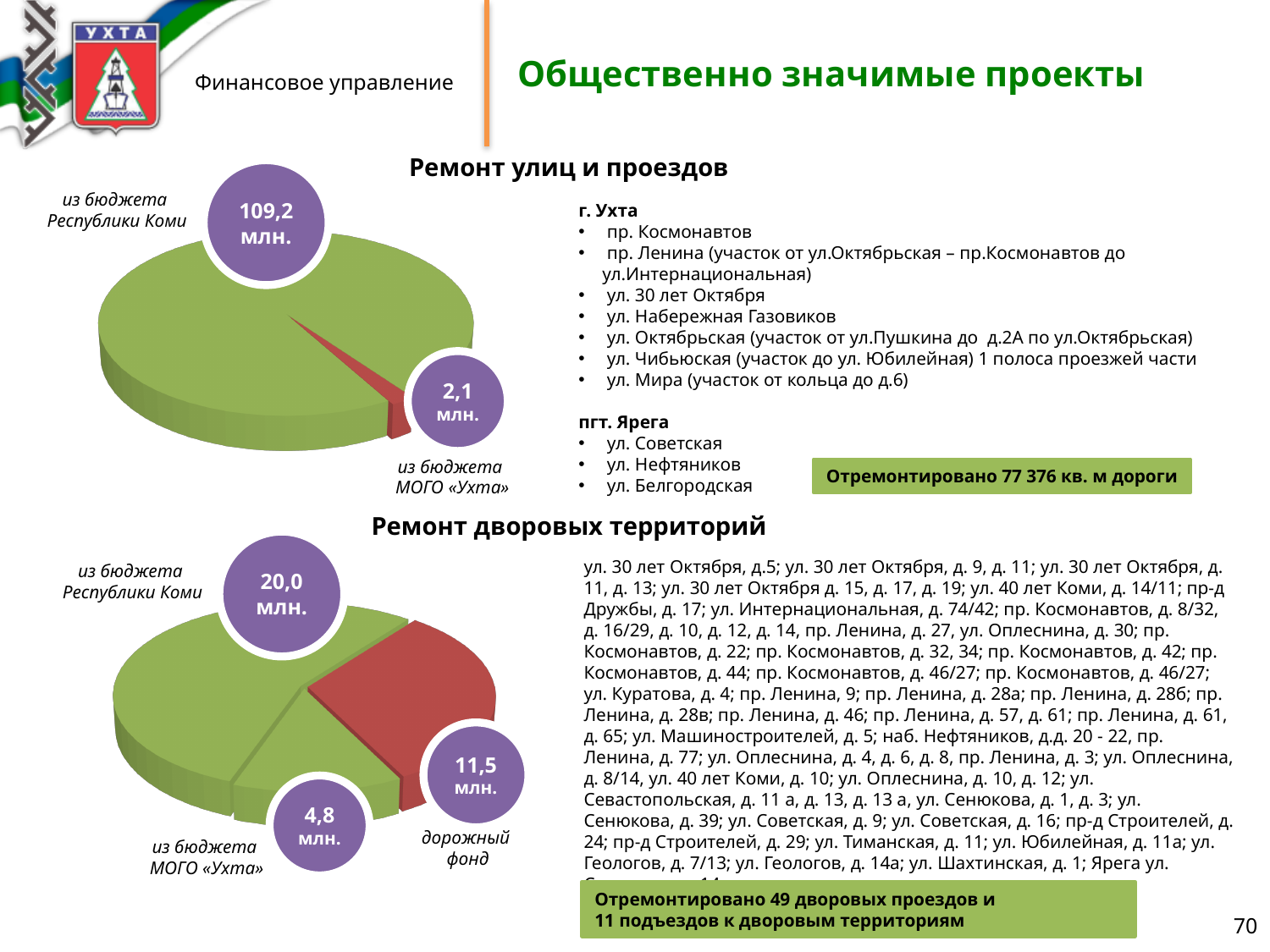
In the 'Ремонт дворовых территорий' chart, what is the value for 'из бюджета МОГО «Ухта»'? 4,8 млн. In the 'Ремонт улиц и проездов' chart, which source is the largest? из бюджета Республики Коми In the 'Ремонт дворовых территорий' chart, which is larger: 'из бюджета Республики Коми' or 'дорожный фонд'? из бюджета Республики Коми In the 'Ремонт дворовых территорий' chart, what is the difference between 'из бюджета Республики Коми' and 'из бюджета МОГО «Ухта»'? 15,2 млн. In the 'Ремонт дворовых территорий' chart, which source is the smallest? из бюджета МОГО «Ухта» In the 'Ремонт дворовых территорий' chart, how many slices are there? 3 In the 'Ремонт улиц и проездов' chart, how many slices are there? 2 In the 'Ремонт улиц и проездов' chart, what is the value for 'из бюджета МОГО «Ухта»'? 2,1 млн. In the 'Ремонт дворовых территорий' chart, what is the value for 'дорожный фонд'? 11,5 млн. In the 'Ремонт улиц и проездов' chart, what is the difference between the Republic of Komi budget and the MOGO «Ухта» budget? 107,1 млн. In the 'Ремонт улиц и проездов' chart, what is the value for 'из бюджета Республики Коми'? 109,2 млн. What kind of chart is used for 'Ремонт улиц и проездов'? pie chart